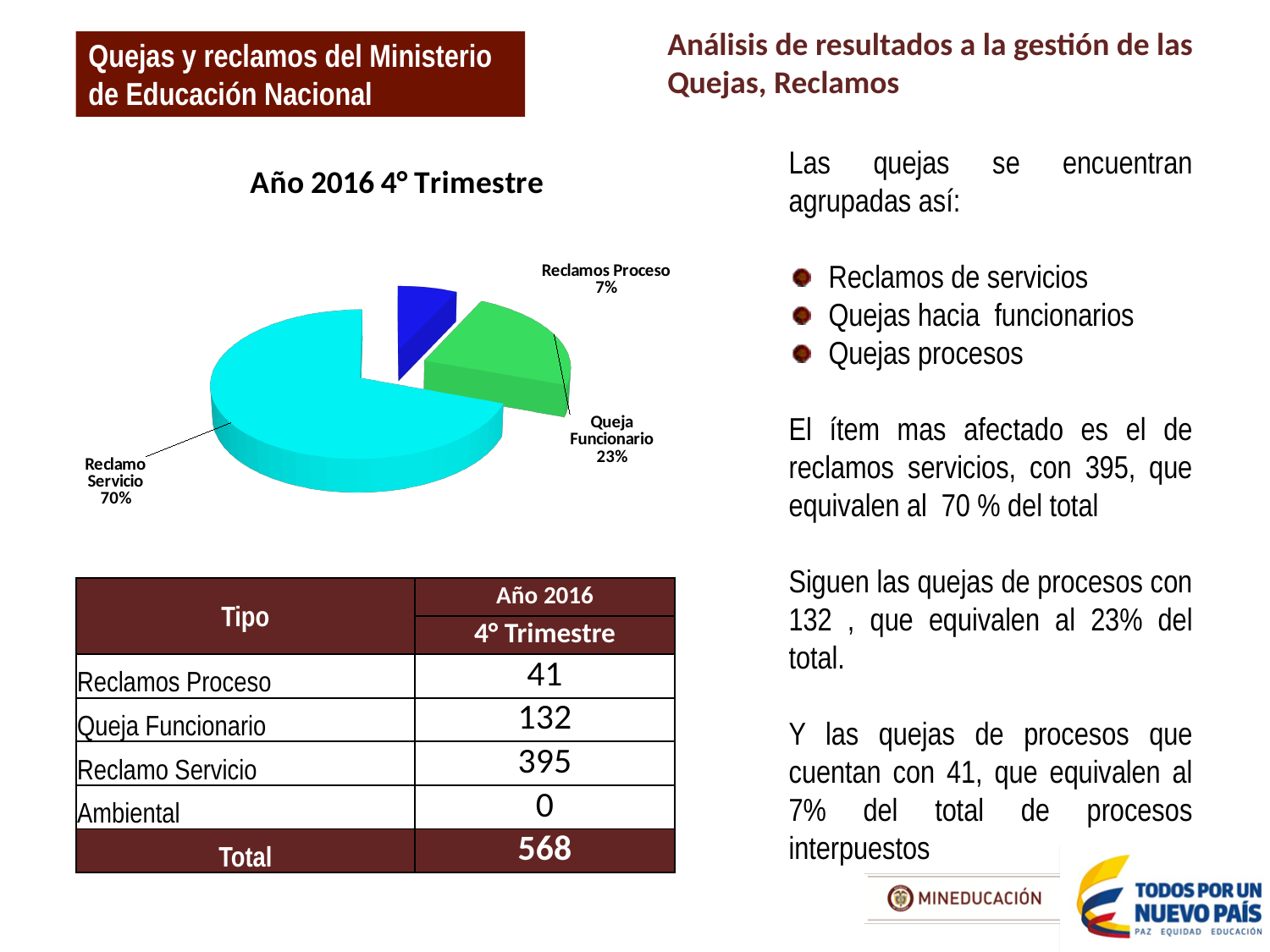
What is the title of the pie chart? Año 2016 4º Trimestre What share of the pie does Queja Funcionario represent? 23% How many slices does the pie chart have? 3 What share of the pie does Reclamos Proceso represent? 7% What kind of chart is shown on the slide? pie chart Is the share for Queja Funcionario greater or less than 25%? less Which slice of the pie chart is the largest? Reclamo Servicio What share of the pie does Reclamo Servicio represent? 70% Which slice of the pie chart is the smallest? Reclamos Proceso Which is larger in the pie chart, Queja Funcionario or Reclamos Proceso? Queja Funcionario What is the difference in percentage points between the Reclamo Servicio and Queja Funcionario slices? 47% What colour is the Reclamo Servicio slice in the pie chart? cyan